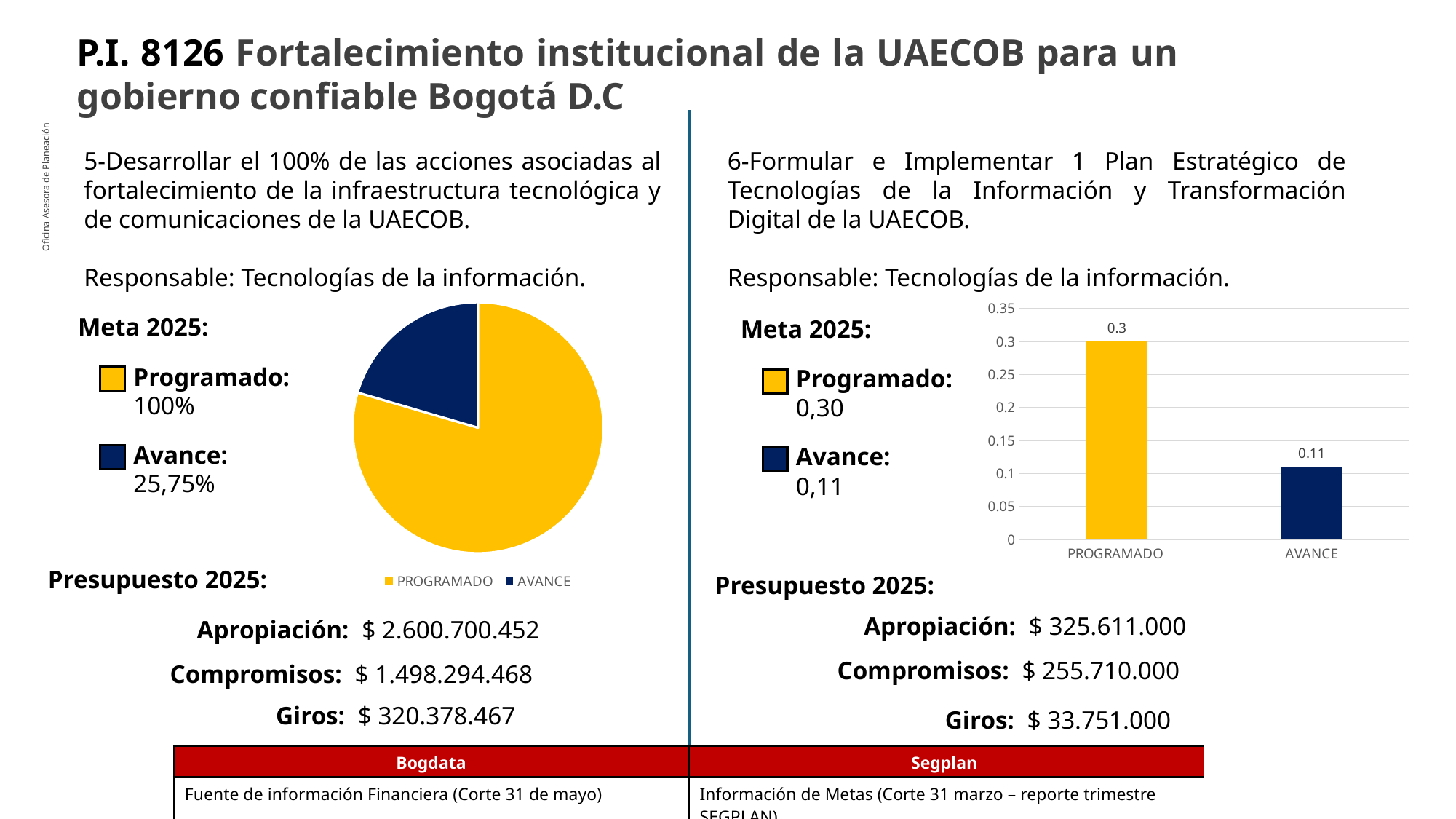
What kind of chart is the chart on the right side of the slide? bar chart In the bar chart on the right, which category has the highest value? PROGRAMADO In the pie chart on the left, what colour is the AVANCE slice? dark blue What kind of chart is the chart on the left side of the slide? pie chart In the bar chart on the right, which category has the lowest value? AVANCE In the bar chart on the right, what is the difference between the PROGRAMADO and AVANCE values? 0.19 In the bar chart on the right, what is the value for PROGRAMADO? 0.3 In the pie chart on the left, which slice is larger, PROGRAMADO or AVANCE? PROGRAMADO How many entries does the legend of the pie chart on the left list? 2 In the bar chart on the right, is the value for AVANCE greater or less than 0.15? less In the bar chart on the right, how many bars are plotted? 2 In the bar chart on the right, what is the value for AVANCE? 0.11